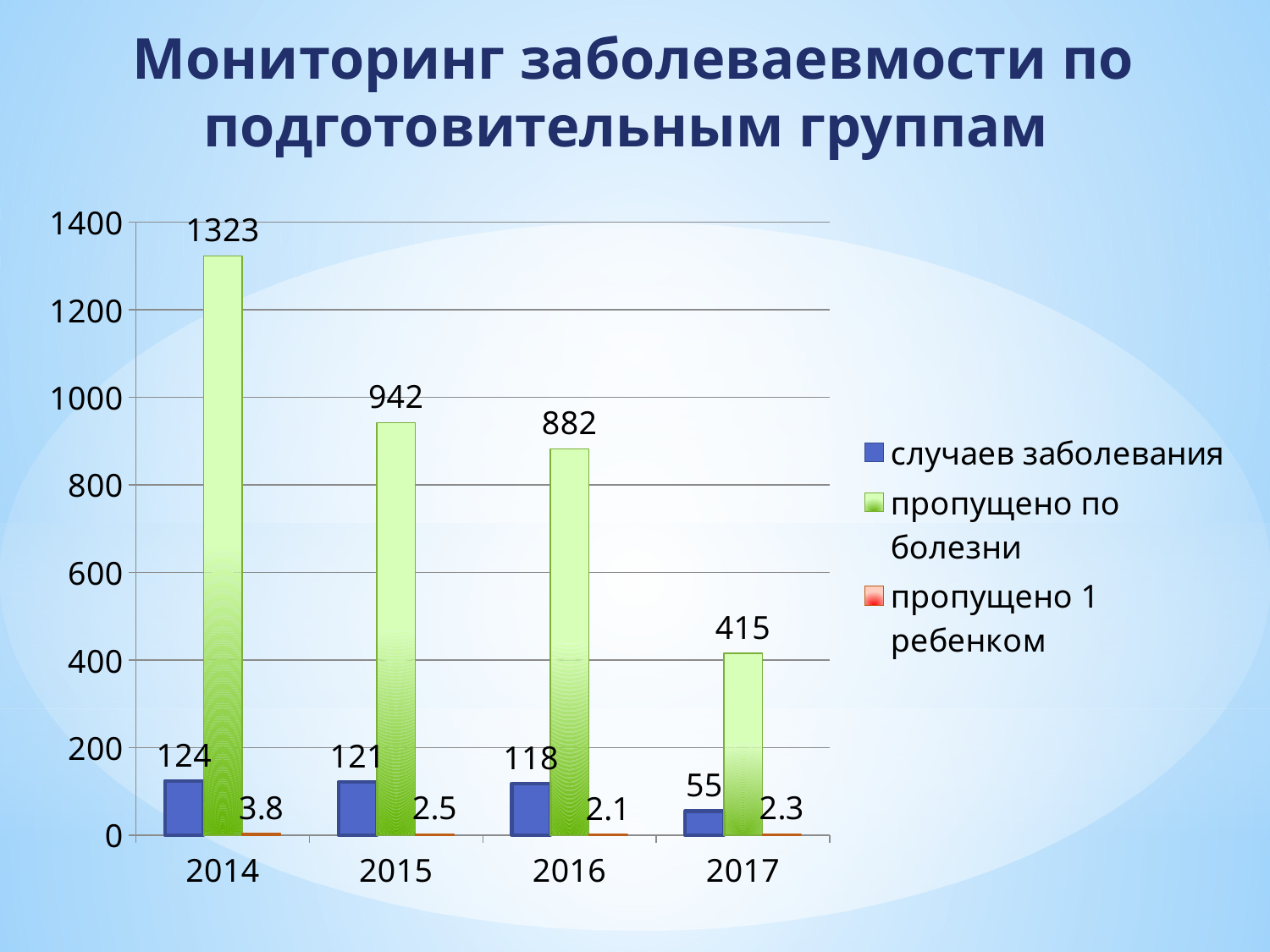
What was the value of "случаев заболевания" in 2017? 55 What is the difference between "пропущено по болезни" in 2015 and 2016? 60 How many series does the legend list? 3 What kind of chart is shown on the slide? bar chart Does "пропущено по болезни" rise or fall from 2014 to 2017? fall Which is larger: "пропущено 1 ребенком" in 2016 or in 2017? 2017 In which year was "пропущено по болезни" the highest? 2014 How many years are shown on the x axis? 4 In which year was "случаев заболевания" the lowest? 2017 What was the value of "пропущено 1 ребенком" in 2015? 2.5 Is the value of "пропущено по болезни" in 2017 greater or less than 400? greater What was the value of "пропущено по болезни" in 2014? 1323